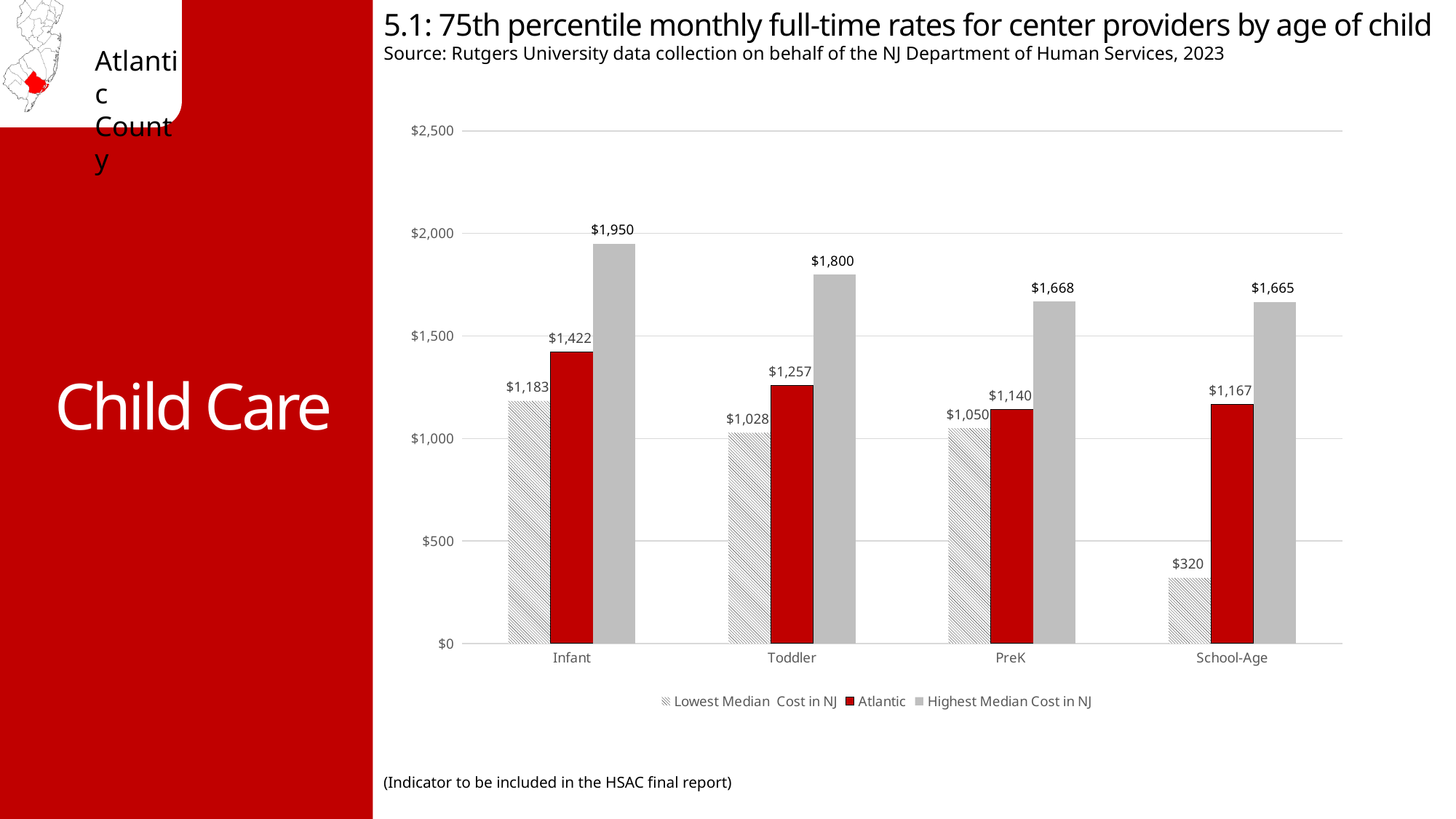
Which age group has the lowest Lowest Median Cost in NJ value? School-Age What is the Highest Median Cost in NJ for Toddler? $1,800 Which series is shown in red? Atlantic Which is larger for Toddler: the Atlantic value or the Lowest Median Cost in NJ value? Atlantic What is the Atlantic value for PreK? $1,140 What kind of chart is shown? Bar chart What is the Atlantic value for Infant? $1,422 What is the Lowest Median Cost in NJ for School-Age? $320 What is the difference between the Highest Median Cost in NJ and the Atlantic value for Infant? $528 How many age groups are shown on the x axis? 4 How many series does the legend list? 3 Which age group has the highest Atlantic value? Infant